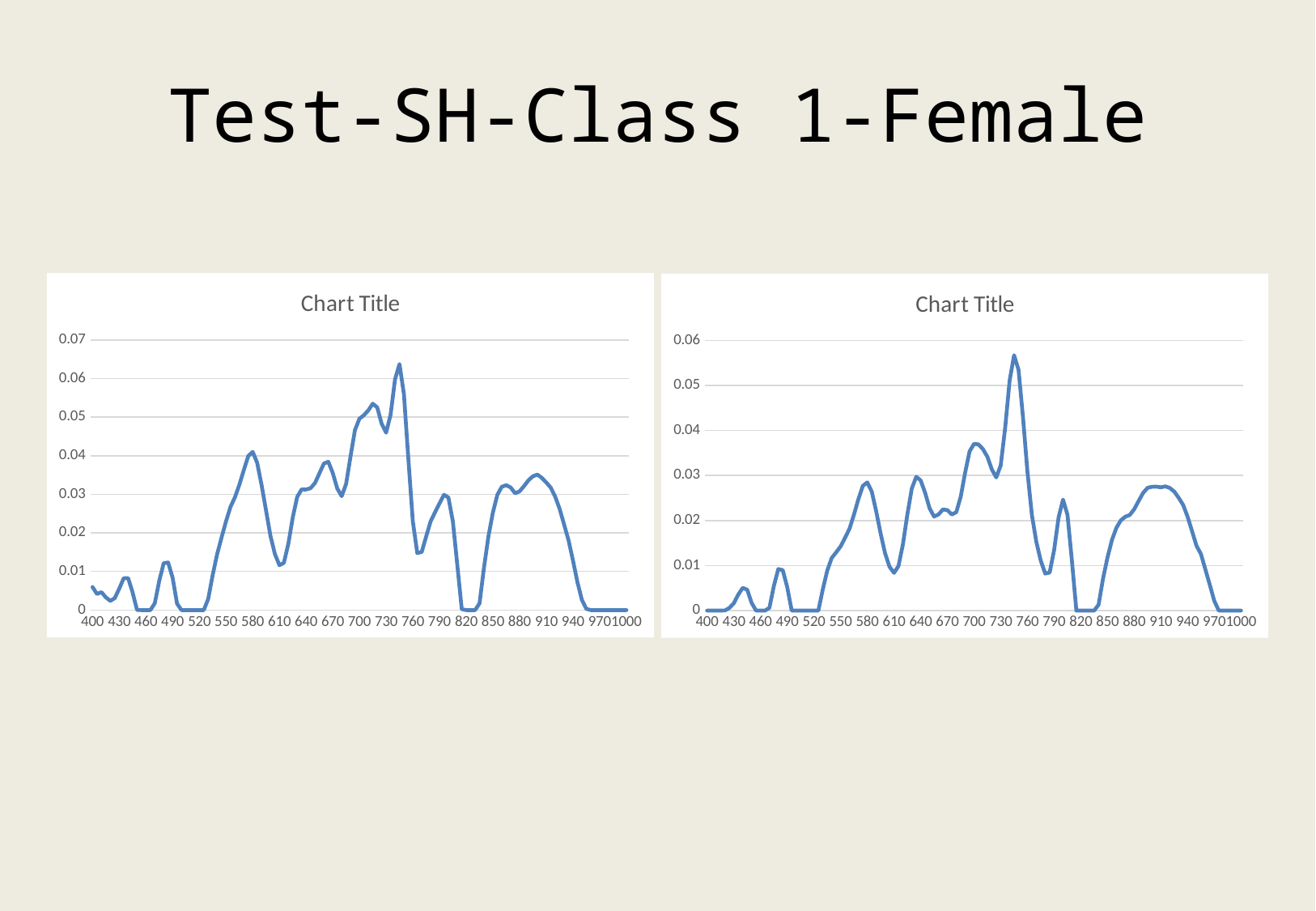
In the right chart, is the value at 700 greater or less than 0.03? greater In the left chart, is the value at 700 greater or less than 0.04? greater In the left chart, is the value at 820 greater or less than 0.01? less What is the title shown on the left chart? Chart Title What is the highest value labelled on the vertical axis of the right chart? 0.06 In the right chart, does the line rise or fall between 940 and 970? fall What kind of chart is the left chart? line chart What kind of chart is the right chart? line chart Which chart reaches a higher peak value, the left chart or the right chart? the left chart